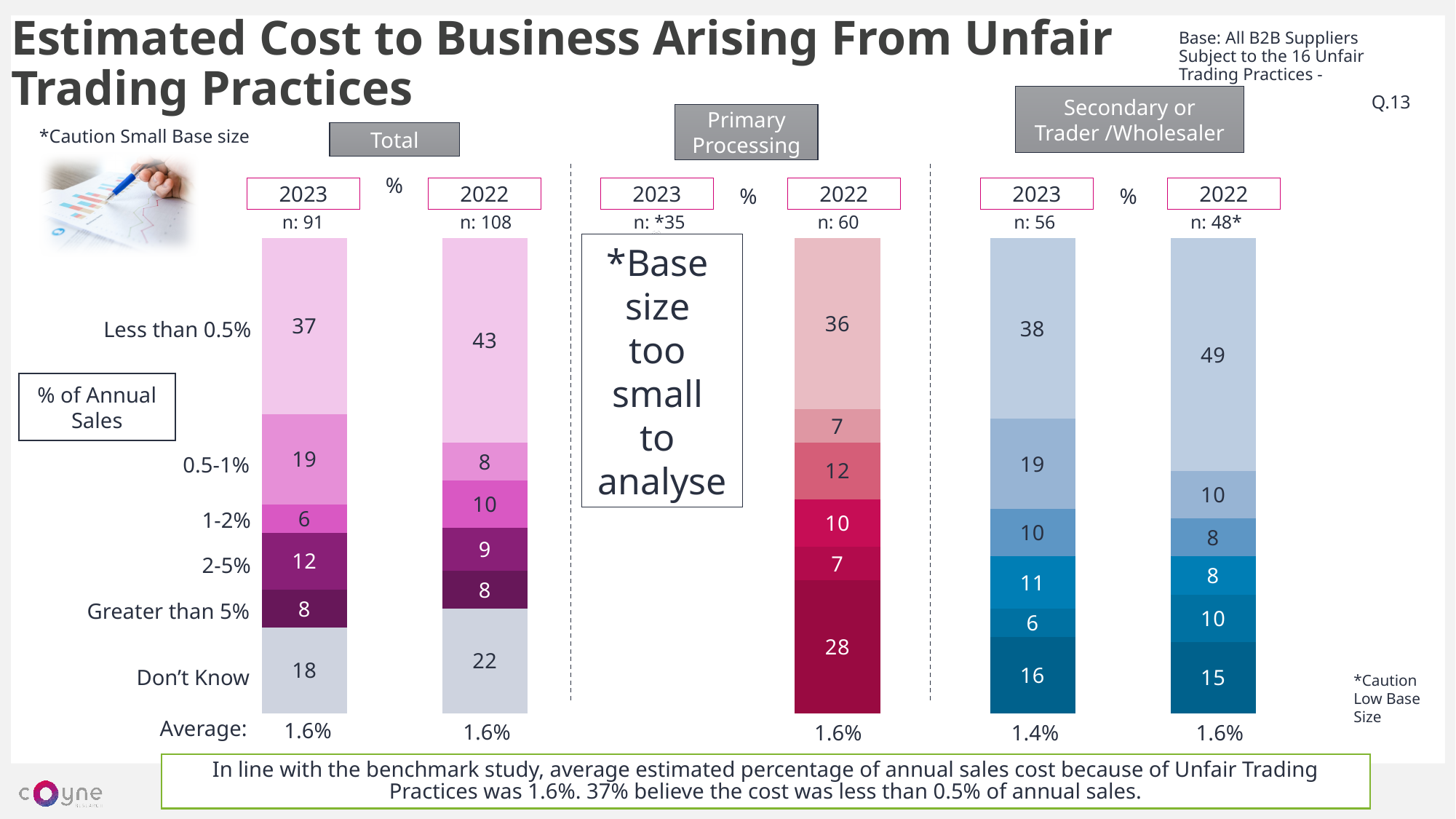
What type of chart is used on this slide? Stacked bar chart What is the average estimated cost shown for Secondary or Trader/Wholesaler in 2023? 1.4% In the Primary Processing chart, what is the 2022 value for 'Greater than 5%'? 7 In the Secondary or Trader/Wholesaler chart, what is the 2022 value for 'Less than 0.5%'? 49 How many cost categories are shown in each stacked bar? 6 In the Total chart, what percentage of suppliers in 2023 estimated the cost at less than 0.5% of annual sales? 37 In the Total chart, which category has the highest value in the 2023 bar? Less than 0.5% In the Secondary or Trader/Wholesaler chart, which category has the lowest value in the 2023 bar? Greater than 5% In the Secondary or Trader/Wholesaler chart, which is larger: the 2023 'Don't Know' value or the 2022 'Don't Know' value? 2023 In the Total chart, what is the difference between the 2023 and 2022 values for '0.5-1%'? 11 In the Total chart, what is the 'Don't Know' value for 2022? 22 Why is there no 2023 bar shown for Primary Processing? Base size too small to analyse